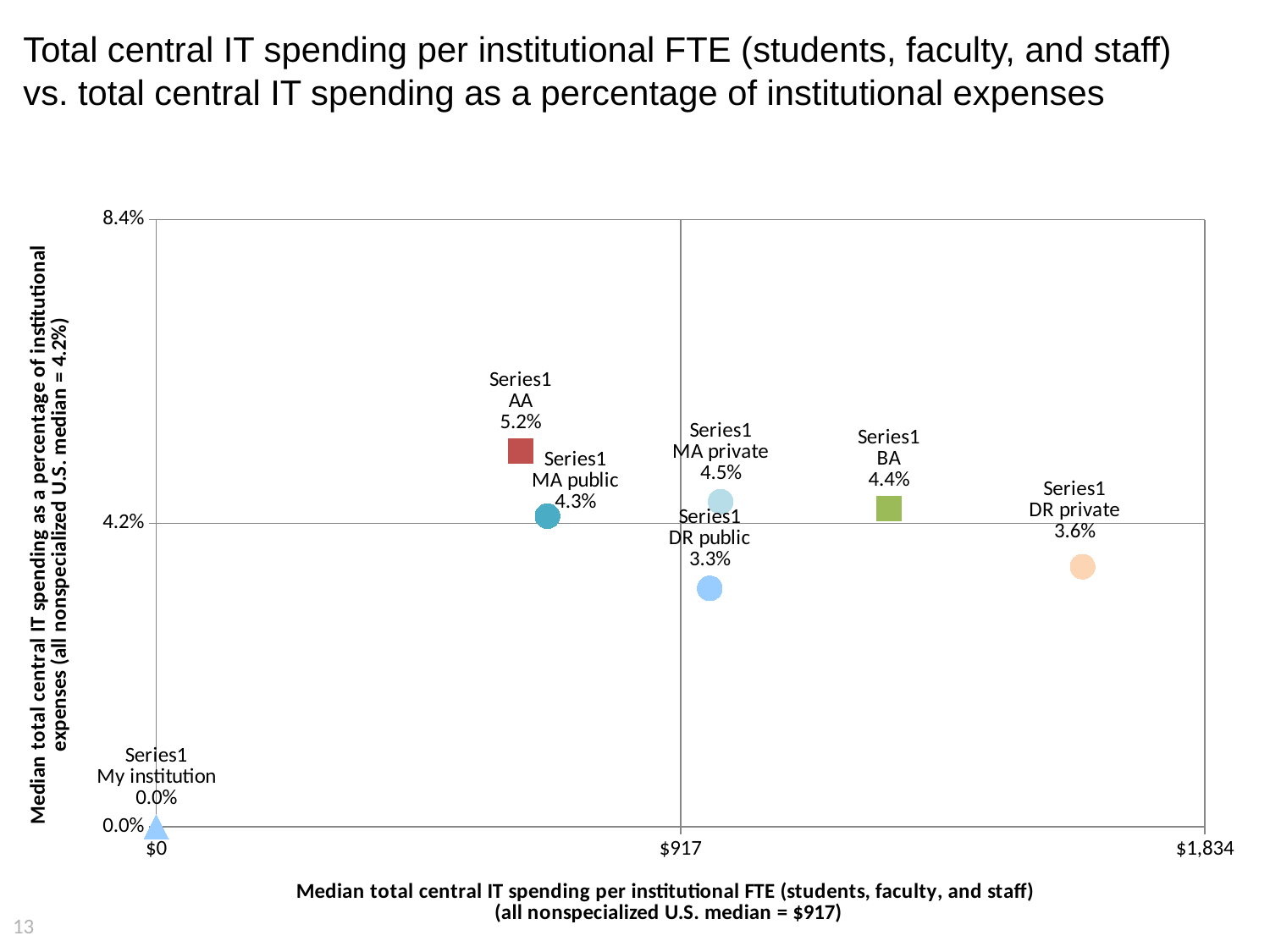
What is the value for AA (total central IT spending as a percentage of institutional expenses)? 5.2% What kind of chart is shown on the slide? Scatter chart How many labeled data points are plotted on the chart? 7 What is the value for DR public (total central IT spending as a percentage of institutional expenses)? 3.3% Is the spending per institutional FTE for AA greater or less than $917? less Which labeled point has the lowest percentage of institutional expenses? My institution Which has a higher percentage of institutional expenses, MA private or BA? MA private What is the difference in percentage points between AA (5.2%) and DR public (3.3%)? 1.9 percentage points Is the spending per institutional FTE for DR private greater or less than $917? greater Which labeled point has the highest percentage of institutional expenses? AA What is the all nonspecialized U.S. median for total central IT spending per institutional FTE shown on the x-axis label? $917 What is the value for MA private (total central IT spending as a percentage of institutional expenses)? 4.5%